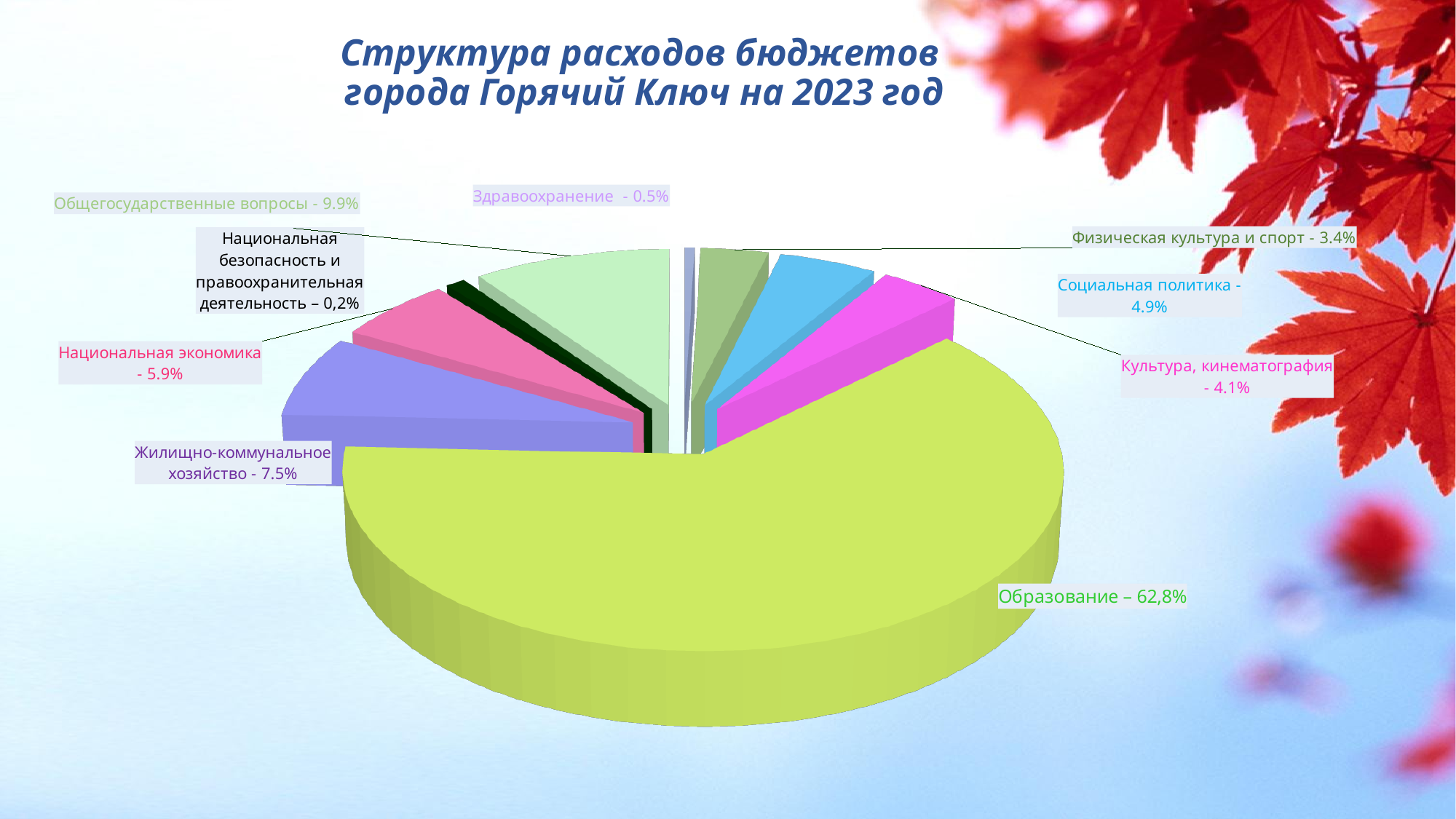
What kind of chart is shown on the slide? Pie chart What share of the budget expenditure goes to Образование? 62,8% Which category has the largest share of the budget expenditure? Образование How many categories are shown in the pie chart? 9 What is the value for Здравоохранение? 0.5% How many percentage points larger is the share for Общегосударственные вопросы than for Жилищно-коммунальное хозяйство? 2.4 Which is larger, the share for Социальная политика or for Культура, кинематография? Социальная политика What is the value for Национальная безопасность и правоохранительная деятельность? 0,2% What is the title of the chart on the slide? Структура расходов бюджетов города Горячий Ключ на 2023 год What is the value for Общегосударственные вопросы? 9.9% What is the value for Жилищно-коммунальное хозяйство? 7.5%